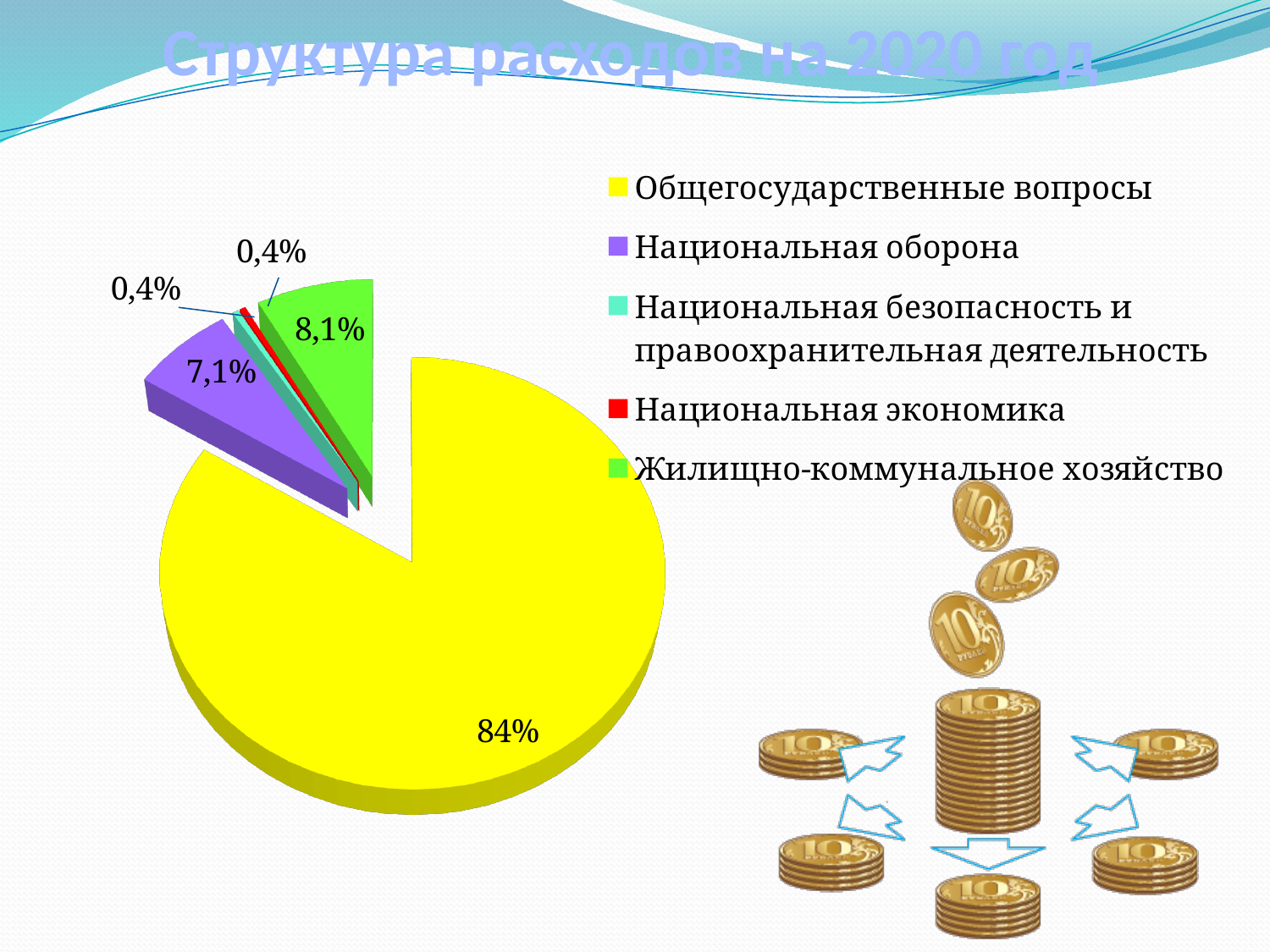
What kind of chart is shown on the slide? pie chart How many categories does the legend list? 5 What share of the pie does Общегосударственные вопросы have? 84% What colour is the slice for Национальная оборона? purple Which is larger, Жилищно-коммунальное хозяйство or Национальная оборона? Жилищно-коммунальное хозяйство What is the value shown for Национальная оборона? 7,1% What is the value shown for Национальная безопасность и правоохранительная деятельность? 0,4% What is the title of the chart? Структура расходов на 2020 год What is the difference between the shares of Жилищно-коммунальное хозяйство and Национальная оборона? 1% What is the value shown for Национальная экономика? 0,4% What is the value shown for Жилищно-коммунальное хозяйство? 8,1% Which category has the largest share of the pie? Общегосударственные вопросы